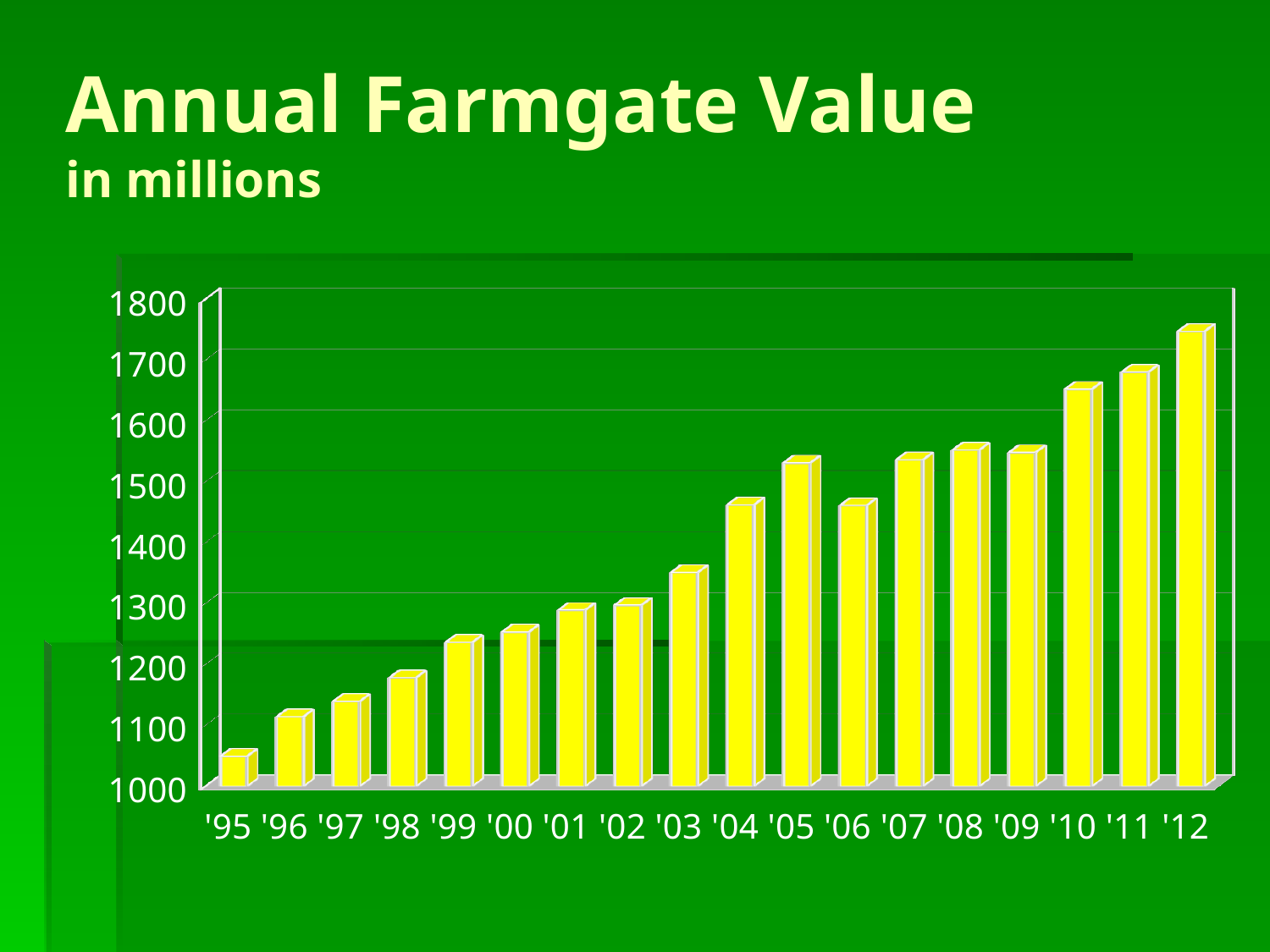
How many years are plotted on the x axis? 18 Is the value for '95 greater or less than 1100? less Is the value for '03 greater or less than 1400? less What kind of chart is shown on the slide? bar chart Do the values generally rise or fall from '95 to '12? rise What is the title of the chart on the slide? Annual Farmgate Value Is the value for '10 greater or less than 1600? greater Which year has the larger value, '05 or '06? '05 Which year has the lowest annual farmgate value? '95 Which year has the highest annual farmgate value? '12